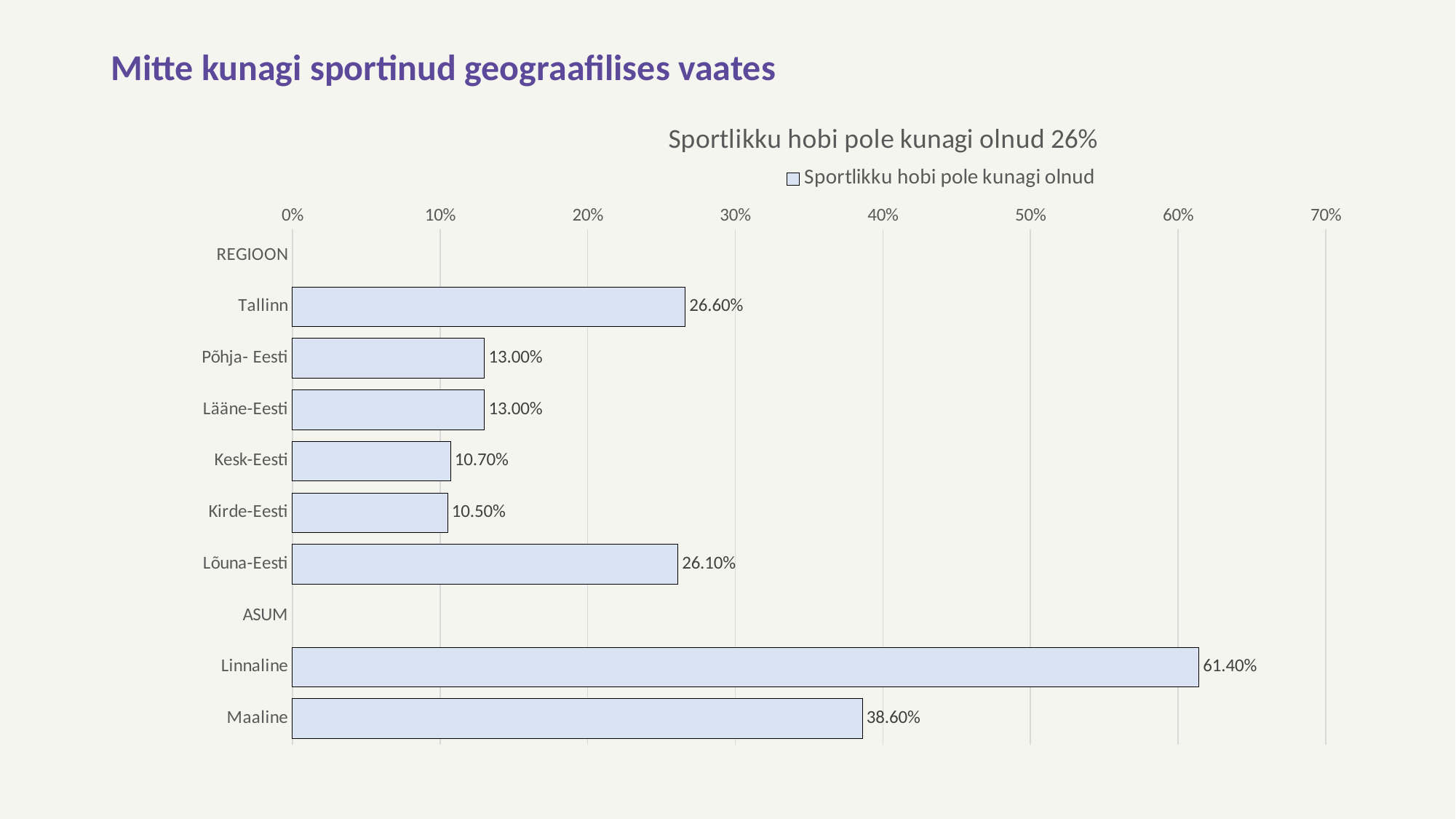
Is the value for Maaline greater or less than 30%? greater What is the value for Tallinn? 26.60% What is the value for Maaline? 38.60% What is the value for Kesk-Eesti? 10.70% What is the difference between the values for Tallinn and Põhja- Eesti? 13.60% Which category has the highest value? Linnaline How many series does the legend list? 1 What kind of chart is shown on the slide? bar chart What is the value for Linnaline? 61.40% Which is larger, the value for Tallinn or the value for Lõuna-Eesti? Tallinn Which category has the lowest value? Kirde-Eesti What is the difference between the values for Linnaline and Maaline? 22.80%